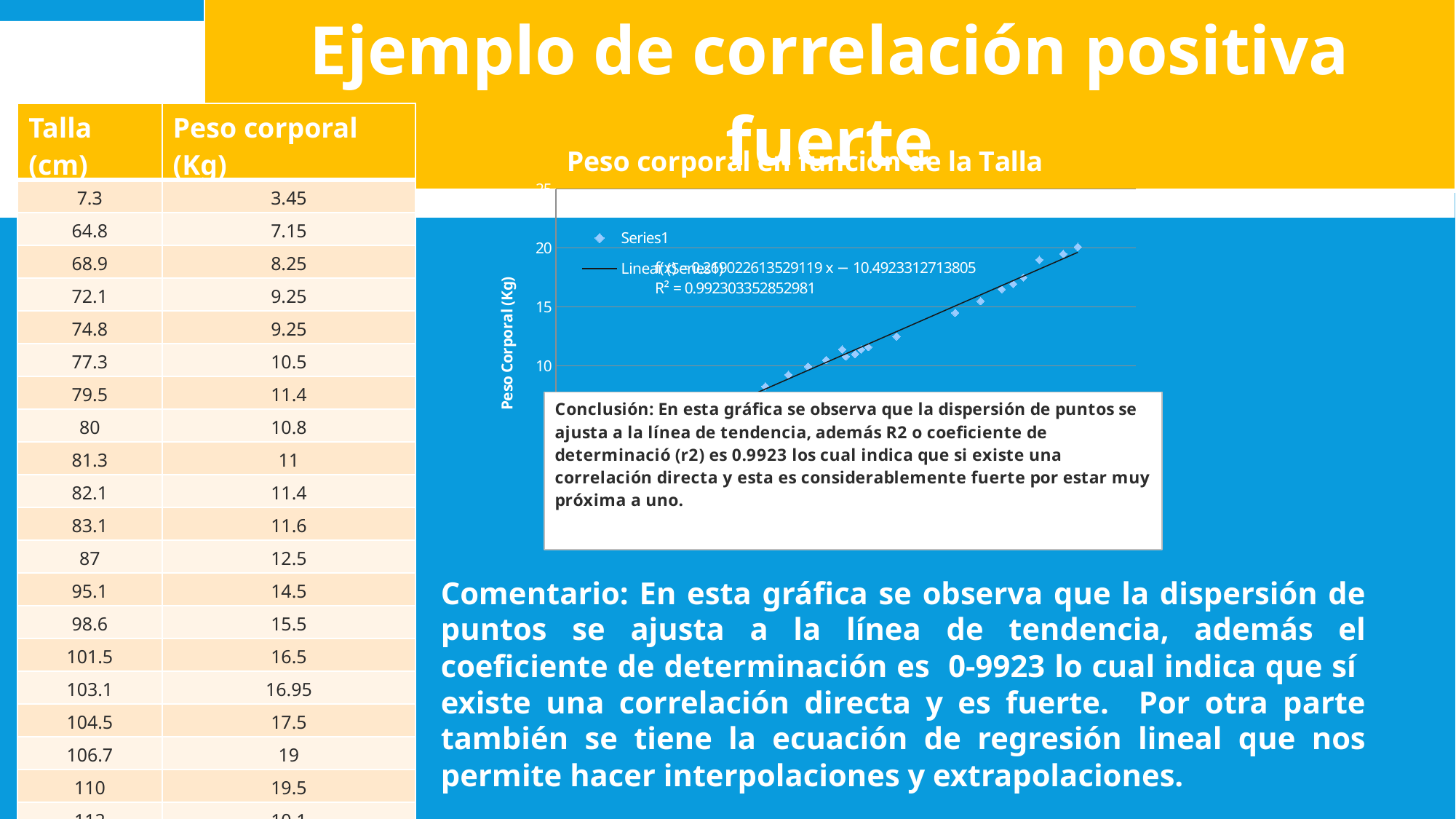
Do the plotted points rise or fall as you move from left to right along the x axis? Rise What kind of chart is shown on the slide? Scatter chart What R² value is printed on the chart? R² = 0.992303352852981 Is the value of the highest plotted point greater or less than 15? greater Is the value of the rightmost plotted point greater or less than 10? greater What is the title of the chart on the slide? Peso corporal en función de la Talla What is the label of the vertical axis of the chart? Peso Corporal (Kg) Does the trendline on the chart slope upward or downward? Upward How many entries does the chart's legend list? 2